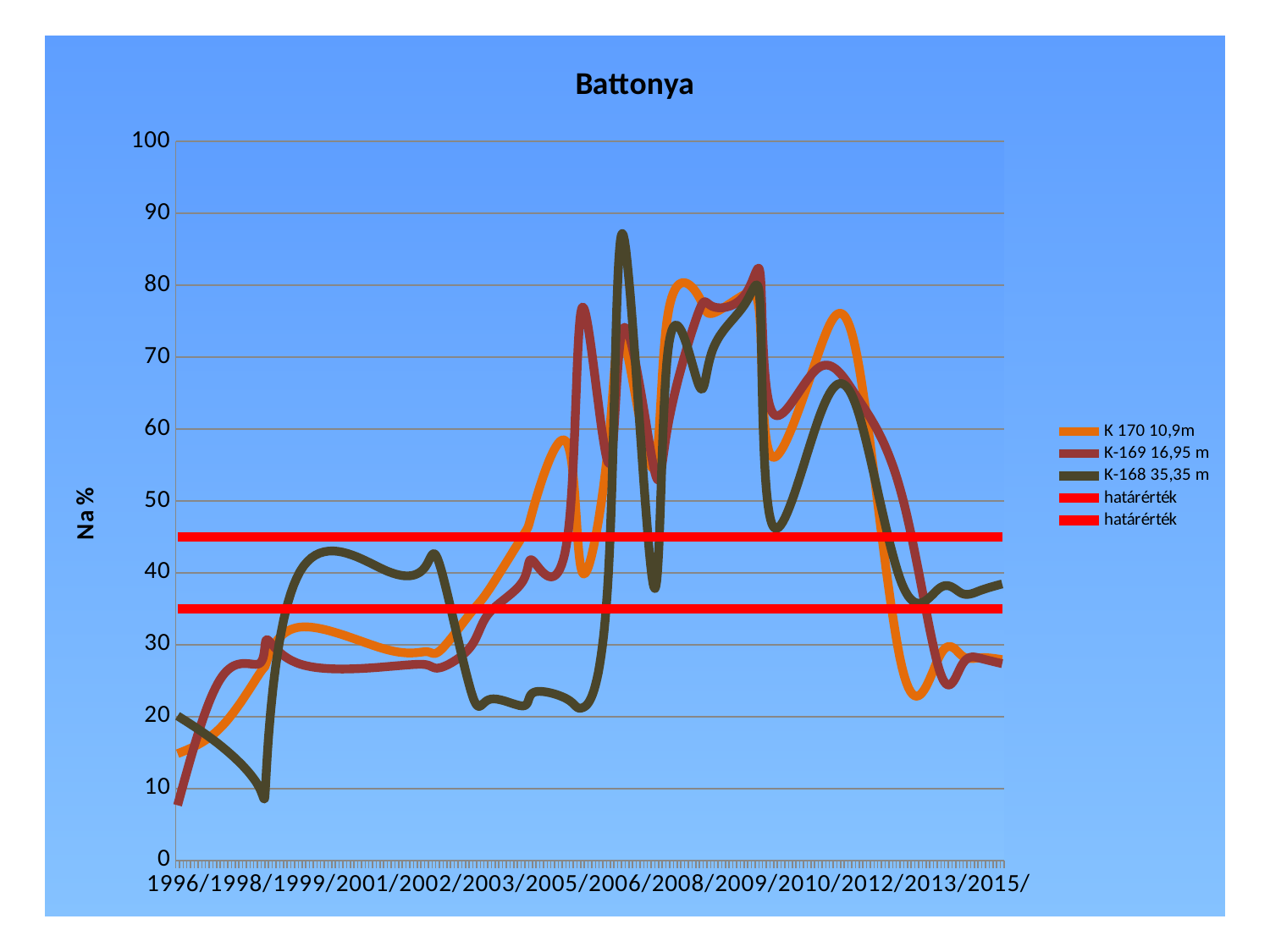
Is the highest value reached by K-168 35,35 m greater or less than 80? greater Is the lower határérték line greater or less than 40? less What is the label of the y axis? Na % What is the title of the chart? Battonya Is the value for K 170 10,9m at 1996/ greater or less than 20? less What kind of chart is shown on the slide? line chart Which series reaches the highest value anywhere on the chart? K-168 35,35 m At 2015/, which is higher: K-168 35,35 m or K 170 10,9m? K-168 35,35 m Between 1996/ and 1999/, does the value for K 170 10,9m rise or fall? rise How many series does the legend list? 5